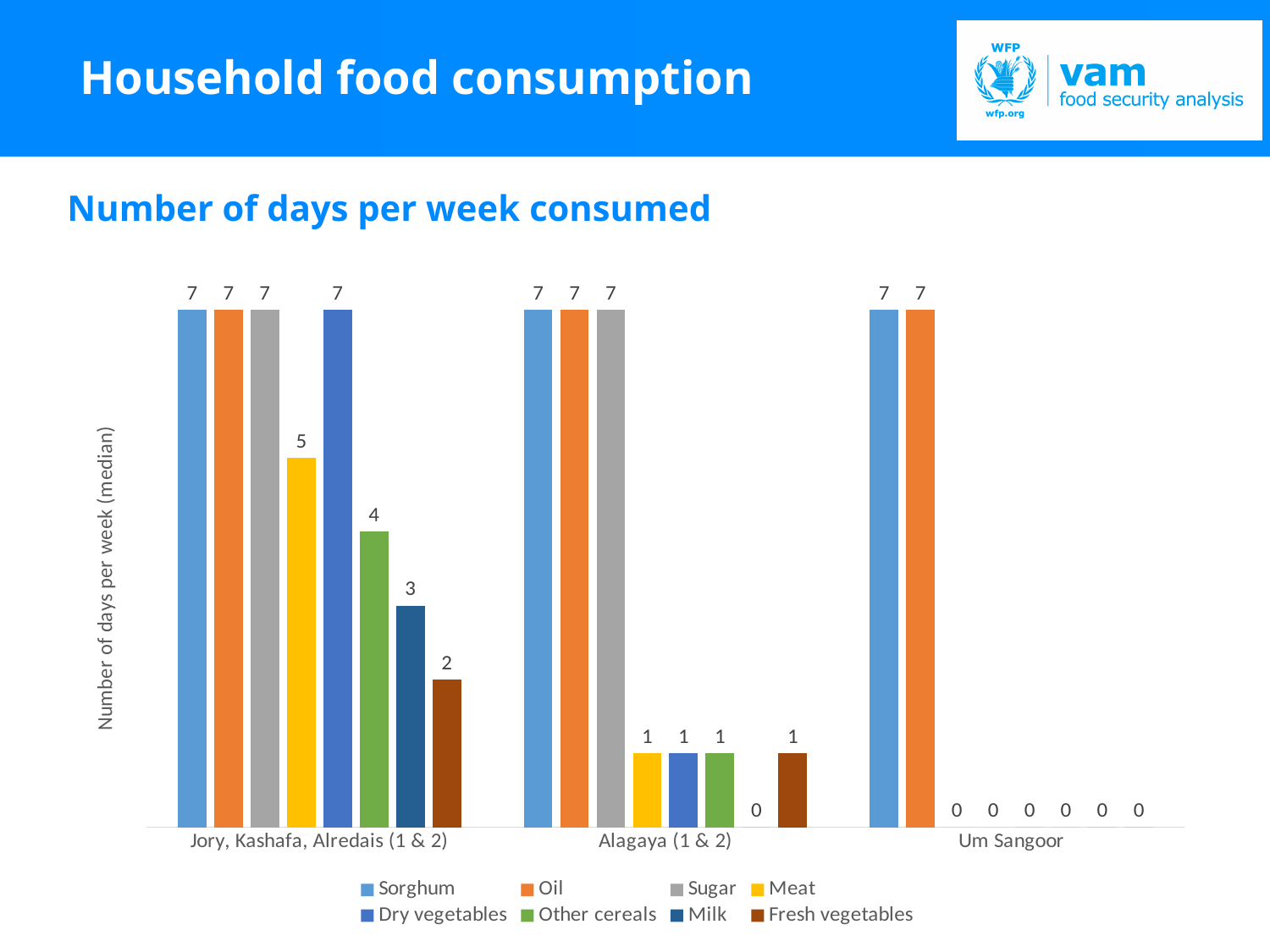
How many food items does the legend list? 8 What is the median number of days per week oil is consumed in Um Sangoor? 7 What type of chart is shown on the slide? Bar chart What is the label of the vertical axis of the chart? Number of days per week (median) What is the difference between the median days per week of meat consumption in Jory, Kashafa, Alredais (1 & 2) and in Alagaya (1 & 2)? 4 What is the median number of days per week milk is consumed in Jory, Kashafa, Alredais (1 & 2)? 3 What is the median number of days per week fresh vegetables are consumed in Jory, Kashafa, Alredais (1 & 2)? 2 What is the median number of days per week milk is consumed in Alagaya (1 & 2)? 0 Which is larger: the median days per week of other cereals consumption in Jory, Kashafa, Alredais (1 & 2) or in Alagaya (1 & 2)? Jory, Kashafa, Alredais (1 & 2) Which food item has the lowest median number of days per week consumed in Jory, Kashafa, Alredais (1 & 2)? Fresh vegetables How many location groups are shown on the x axis of the chart? 3 What is the median number of days per week meat is consumed in Jory, Kashafa, Alredais (1 & 2)? 5